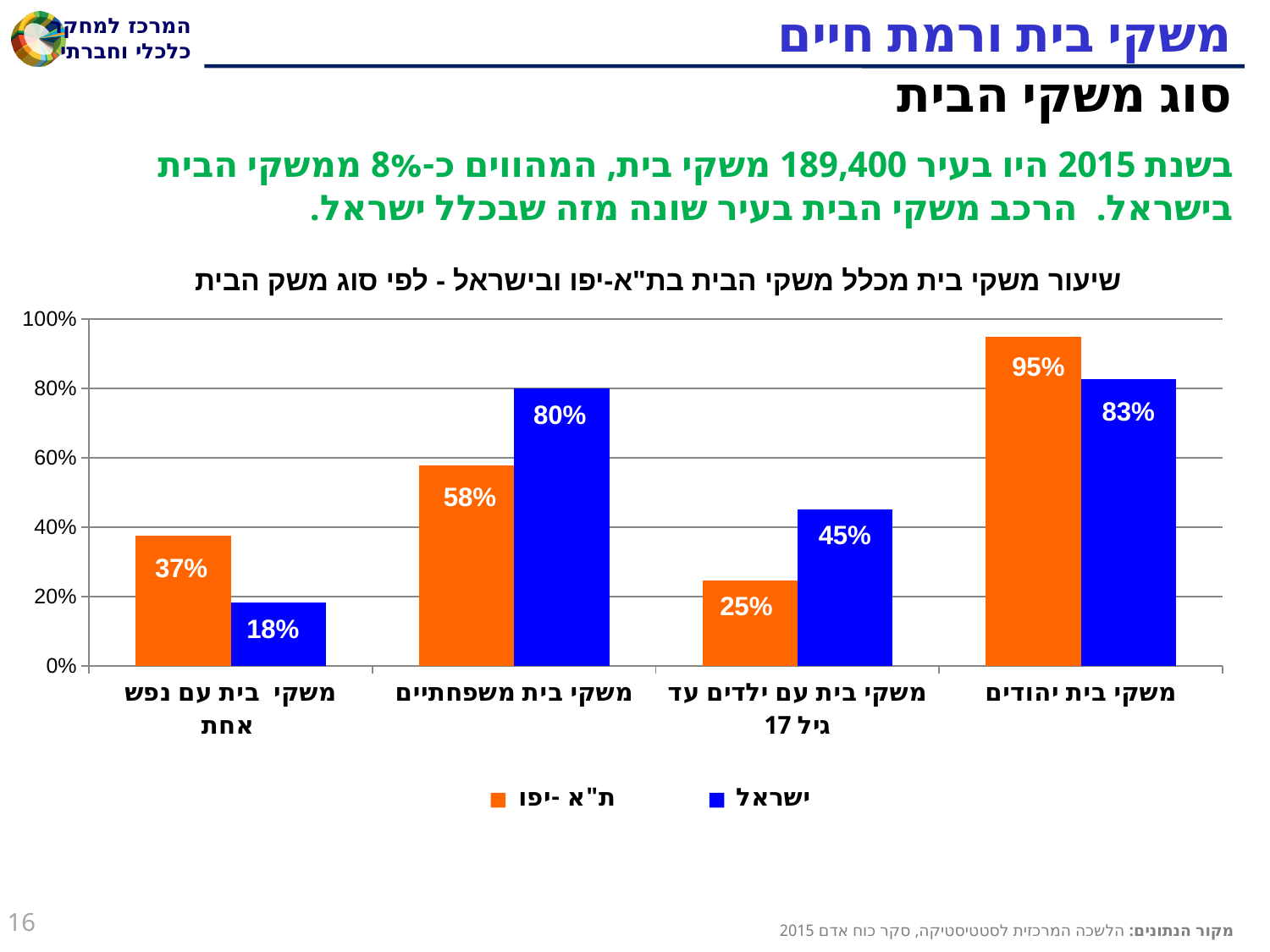
Which colour represents the ישראל series in the chart? blue What is the value for ישראל in the category משקי בית משפחתיים? 80% In the category משקי בית משפחתיים, which is larger: the value for ת"א -יפו or for ישראל? ישראל How many series does the legend list? 2 Which category has the lowest value for ישראל? משקי בית עם נפש אחת What is the value for ישראל in the category משקי בית יהודים? 83% How many household-type categories are shown on the x axis? 4 What is the difference between the ישראל and ת"א -יפו values for משקי בית עם ילדים עד גיל 17? 20% What type of chart is shown on the slide? bar chart What is the value for ת"א -יפו in the category משקי בית עם נפש אחת? 37% What is the value for ת"א -יפו in the category משקי בית עם ילדים עד גיל 17? 25% Which category has the highest value for ת"א -יפו? משקי בית יהודים